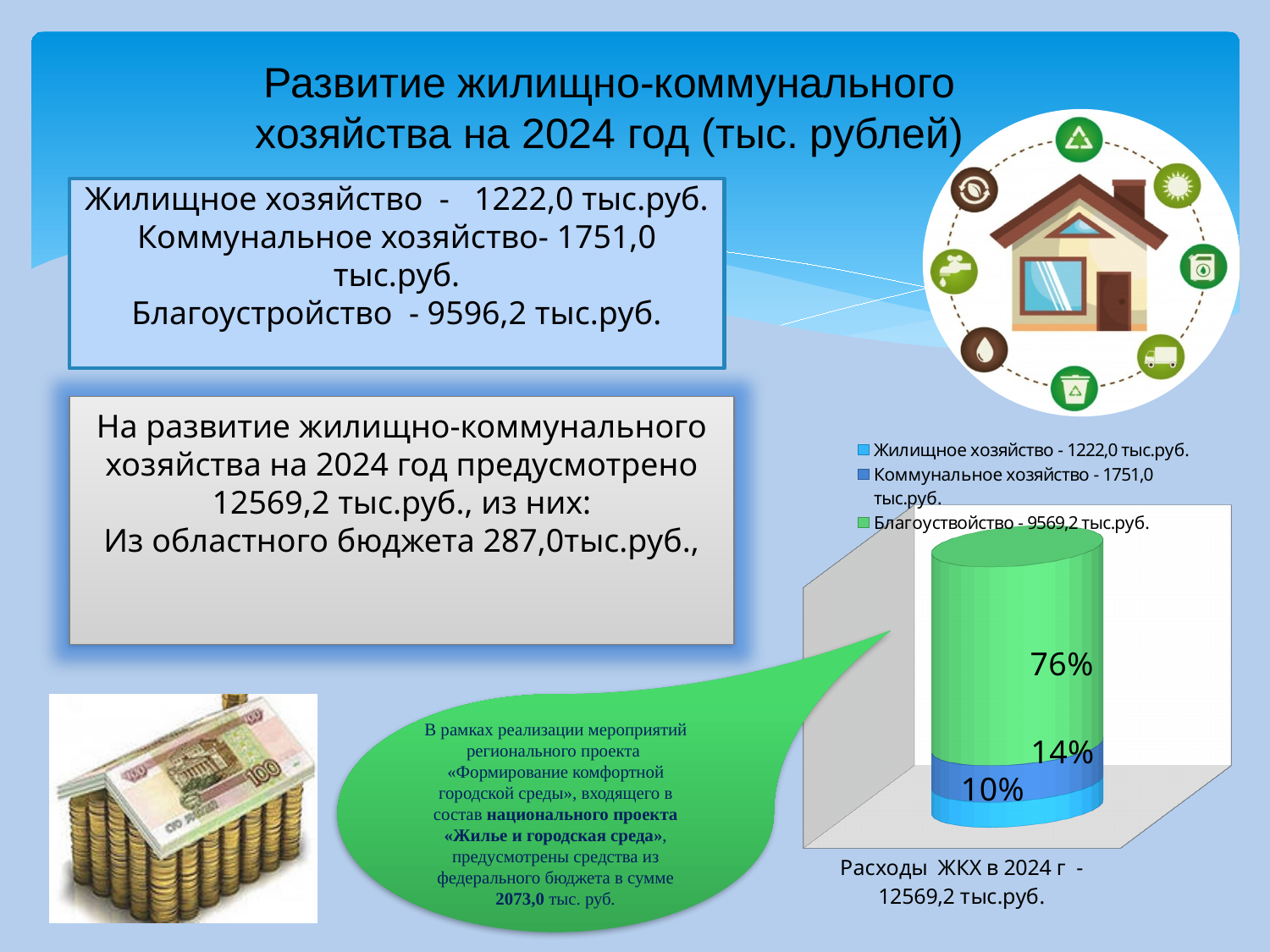
What total amount is stated in the caption below the chart for Расходы ЖКХ в 2024 г? 12569,2 тыс.руб. What is the total of the three percentage labels shown on the stacked bar? 100% What percentage share does the Коммунальное хозяйство segment show in the stacked bar chart? 14% What percentage share does the Жилищное хозяйство segment show in the stacked bar chart? 10% How many series does the chart legend list? 3 By how many percentage points does the Благоустройство share exceed the Коммунальное хозяйство share in the chart? 62% What percentage share does the Благоустройство segment show in the stacked bar chart? 76% By how many percentage points does the Коммунальное хозяйство share exceed the Жилищное хозяйство share in the chart? 4% Which segment of the stacked bar chart has the largest share? Благоустройство Which segment of the stacked bar chart has the smallest share? Жилищное хозяйство What kind of chart is shown on the slide? Stacked bar chart Which has a larger share in the chart, Коммунальное хозяйство or Жилищное хозяйство? Коммунальное хозяйство